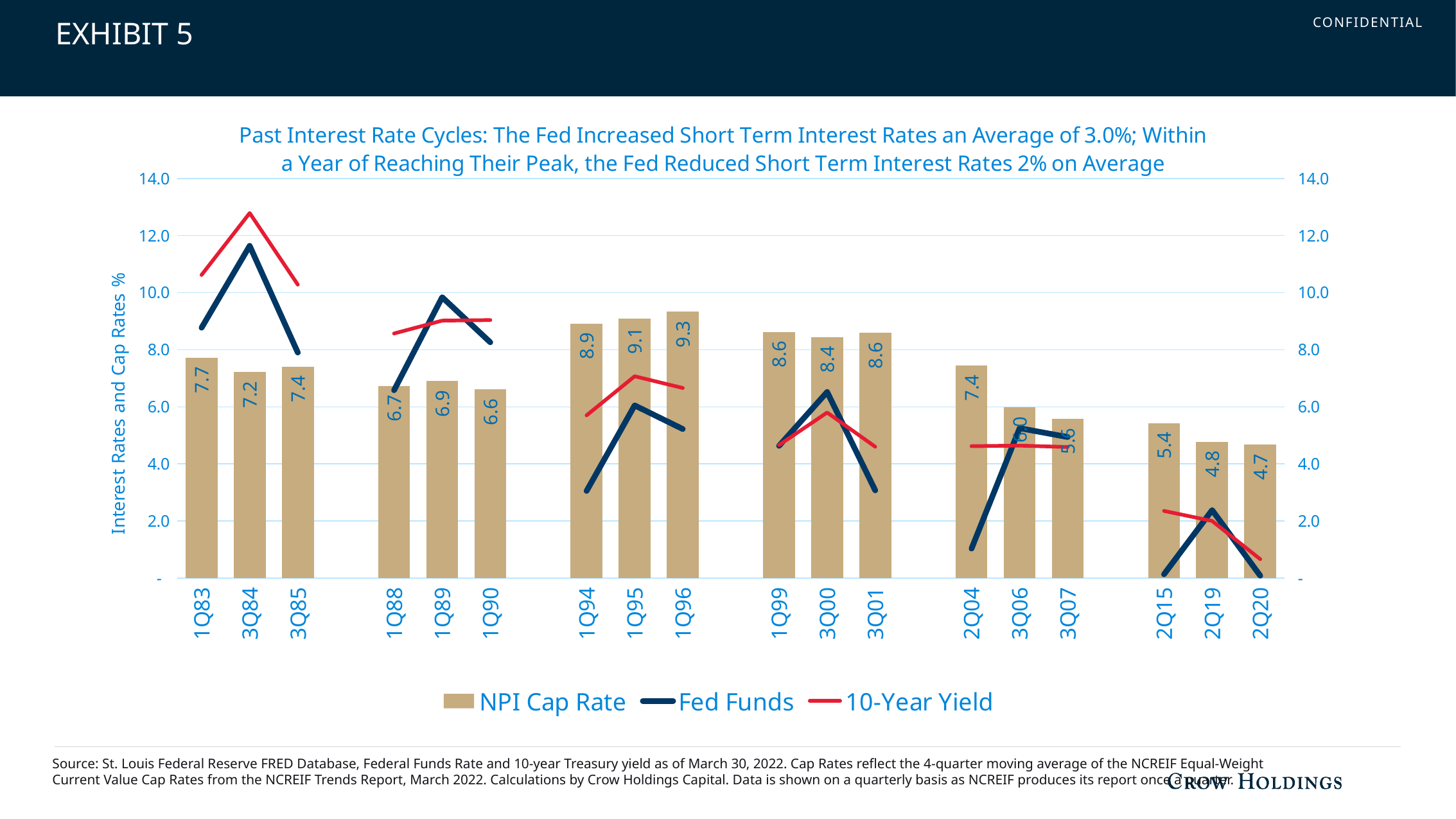
How many series does the legend list? 3 Which period has the highest NPI Cap Rate? 1Q96 What is the NPI Cap Rate for 1Q96? 9.3 Which period has the lowest NPI Cap Rate? 2Q20 Is the Fed Funds value for 2Q15 greater or less than 2.0? less Is the 10-Year Yield value for 3Q84 greater or less than 12.0? greater Is the Fed Funds value for 3Q84 greater or less than 10.0? greater What is the difference between the NPI Cap Rate in 1Q96 and in 2Q20? 4.6 Which is larger, the NPI Cap Rate in 1Q94 or in 1Q99? 1Q94 What is the NPI Cap Rate for 1Q83? 7.7 How many periods are shown on the x axis? 18 What is the NPI Cap Rate for 2Q19? 4.8